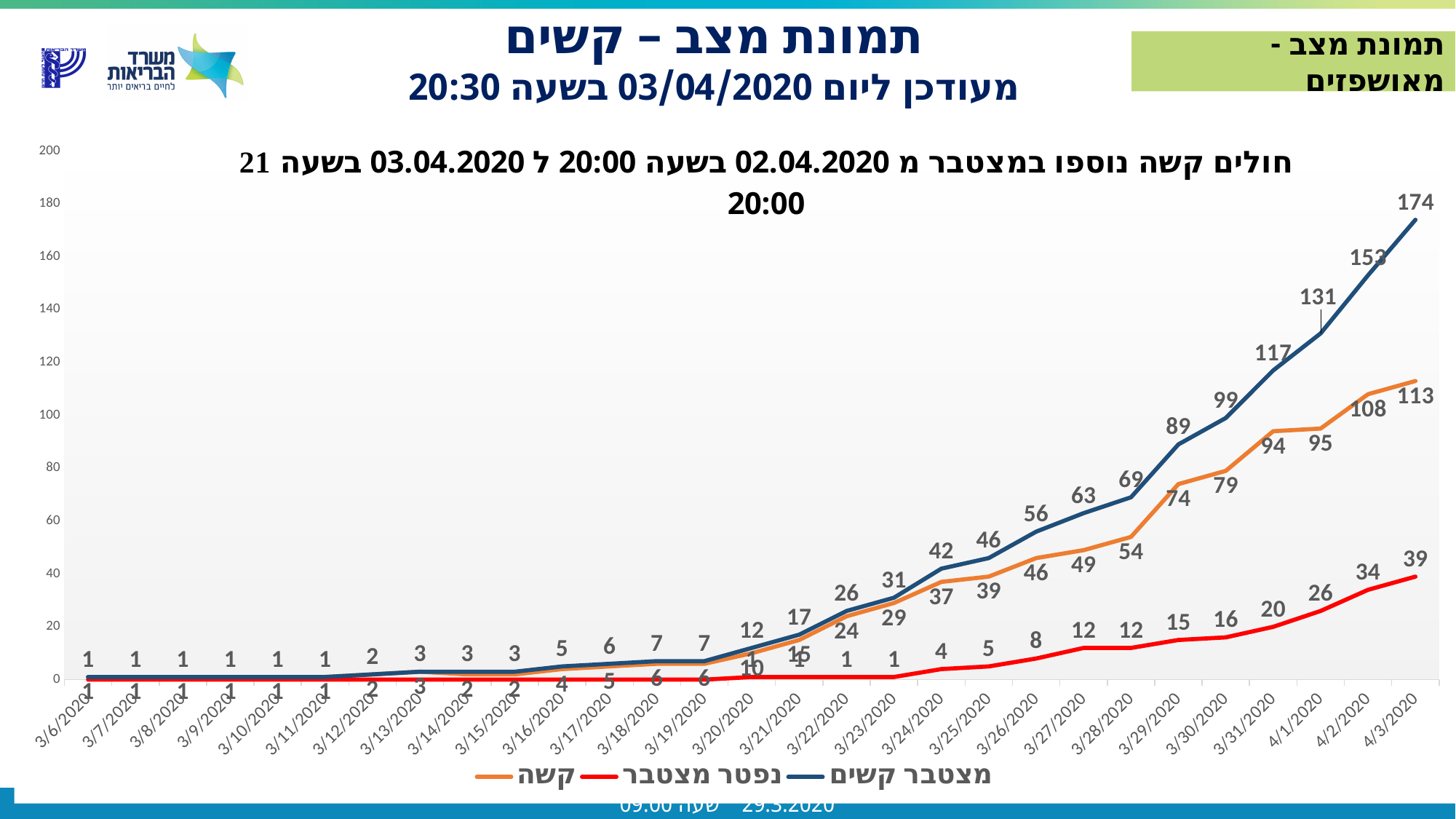
By how much did the מצטבר קשים series increase from 4/2/2020 (153) to 4/3/2020 (174)? 21 How many series does the legend list? 3 What is the value of the מצטבר קשים series on 3/29/2020? 89 How many dates are shown on the x axis? 29 What is the value of the מצטבר קשים series on 4/3/2020? 174 What is the value of the נפטר מצטבר series on 4/3/2020? 39 What is the value of the קשה series on 4/3/2020? 113 What kind of chart is shown on the slide? line chart What is the value of the נפטר מצטבר series on 4/2/2020? 34 On which date does the מצטבר קשים series reach its highest value? 4/3/2020 What is the difference between the קשה values on 4/3/2020 (113) and 4/2/2020 (108)? 5 Does the מצטבר קשים series rise or fall along the x axis? rise